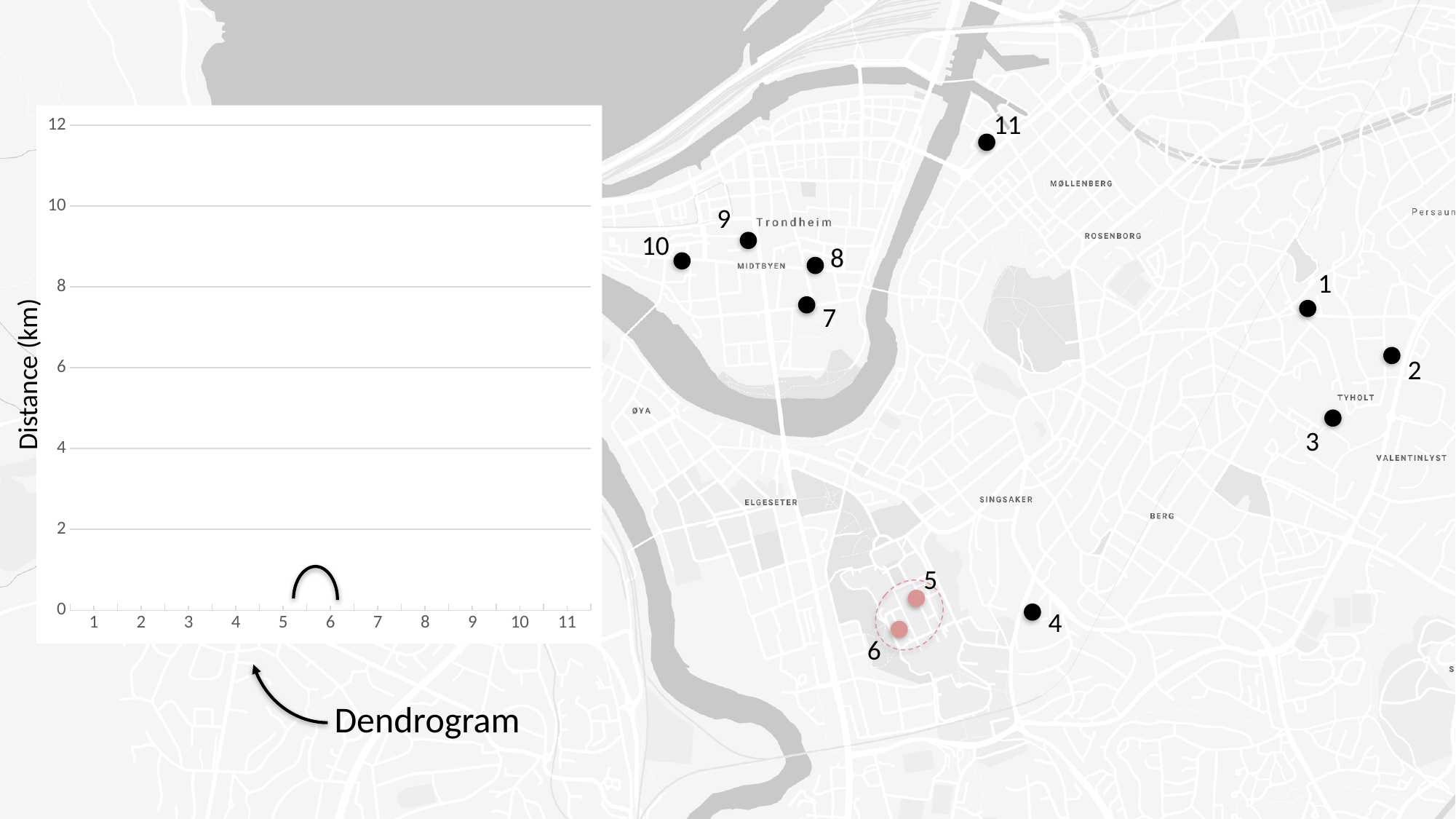
Which two items are joined by the only link drawn in the dendrogram? 5 and 6 How many links (merges) are drawn in the dendrogram? 1 What kind of chart is shown on the left of the slide? Dendrogram What is the highest tick value shown on the vertical axis of the dendrogram? 12 What is the label of the vertical axis of the dendrogram? Distance (km) How many numbered items are listed along the x axis of the dendrogram? 11 Which numbered points on the map are highlighted in pink and circled? 5 and 6 Is the height at which items 5 and 6 are joined in the dendrogram greater or less than 2 km? less How many numbered points are plotted on the map? 11 Is the height at which items 5 and 6 are joined in the dendrogram greater or less than 4 km? less